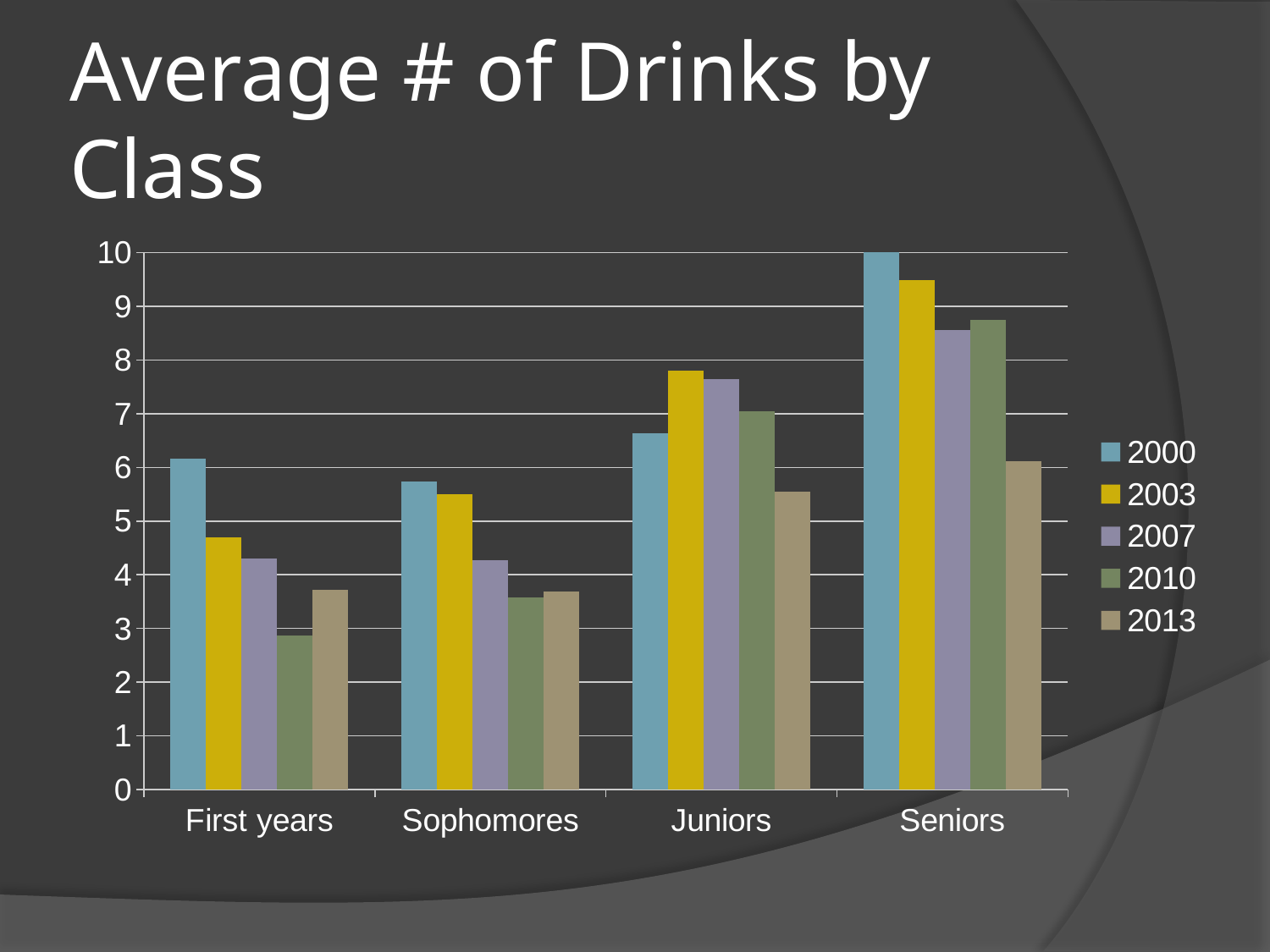
How many class categories are shown on the x axis? 4 Which class has the highest bar for the 2000 series? Seniors How many series does the legend list? 5 For Juniors, which is larger: the 2000 value or the 2003 value? 2003 Do the values for the 2000 series rise or fall from First years to Seniors? Rise Which year has the highest value among First years? 2000 Is the value for Seniors in 2007 greater or less than 8? greater Which class has the lowest bar for the 2010 series? First years Is the value for First years in 2010 greater or less than 3? less Is the value for Juniors in 2003 greater or less than 7? greater Which year has the lowest value among Seniors? 2013 What kind of chart is shown on the slide? Bar chart